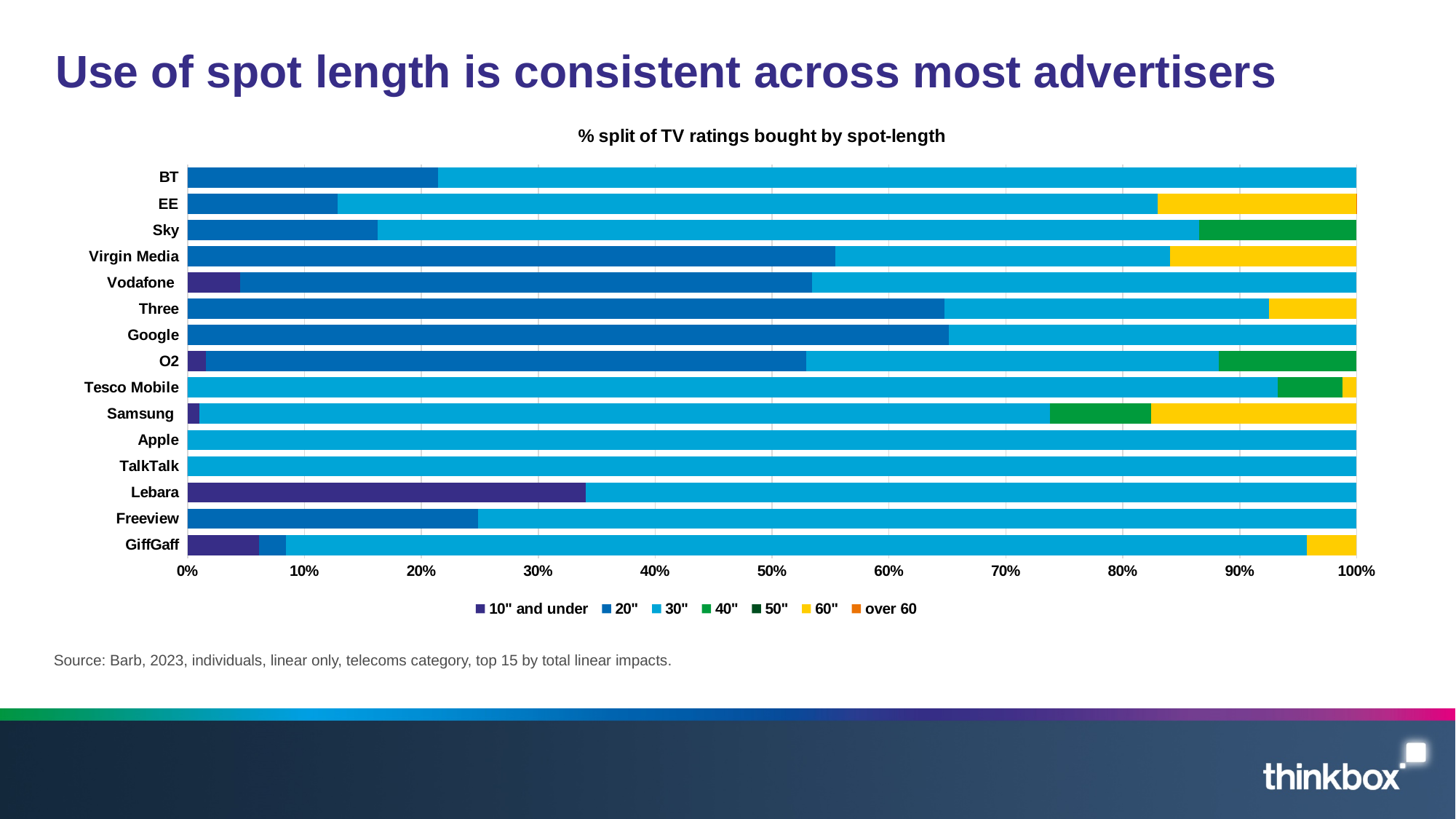
Is the 10" and under share for Lebara greater or less than 30%? greater Which advertiser has the largest share of 10" and under spots? Lebara What is the title of the chart? % split of TV ratings bought by spot-length Which has a larger 10" and under share, Lebara or Vodafone? Lebara What kind of chart is shown on the slide? Stacked bar chart What does each advertiser's stacked bar total? 100% Which has a larger 20" share, Google or BT? Google Is the 20" share for Freeview greater or less than 30%? less How many advertisers are listed on the chart? 15 Is the 20" share for Sky greater or less than 20%? less How many spot-length series does the legend list? 7